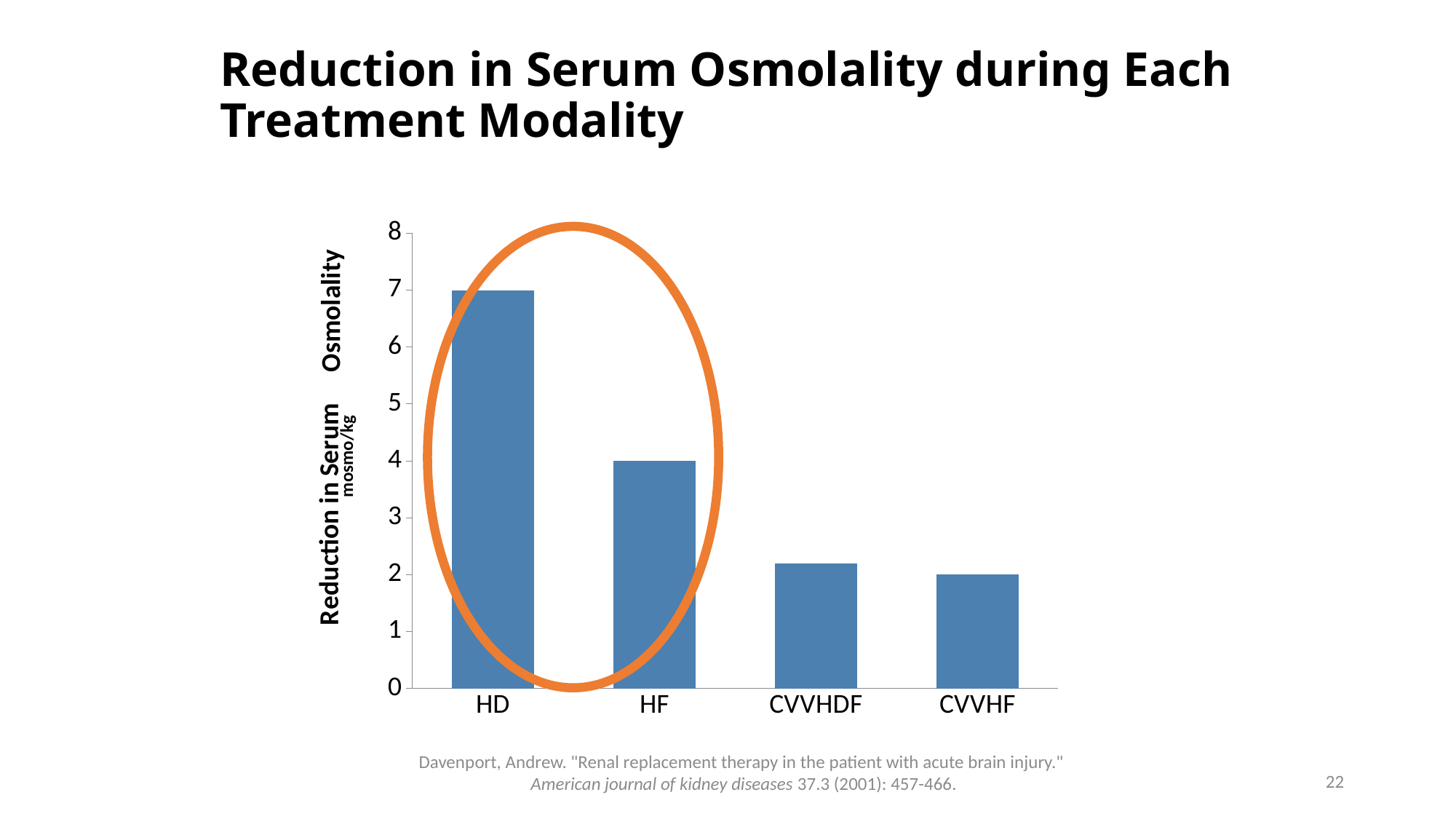
What kind of chart is shown on the slide? bar chart What is the reduction in serum osmolality for CVVHF? 2 Is the value for CVVHDF greater or less than 3? less What is the reduction in serum osmolality for HD? 7 Which two bars are enclosed by the orange oval? HD and HF What unit is given on the y axis label? mosmo/kg Which treatment modality has the highest reduction in serum osmolality? HD Do the values rise or fall moving from HD to CVVHF along the x axis? fall What is the difference between the values for HD and HF? 3 What is the reduction in serum osmolality for HF? 4 Which has a larger reduction in serum osmolality, HF or CVVHDF? HF How many treatment modalities are shown on the x axis? 4